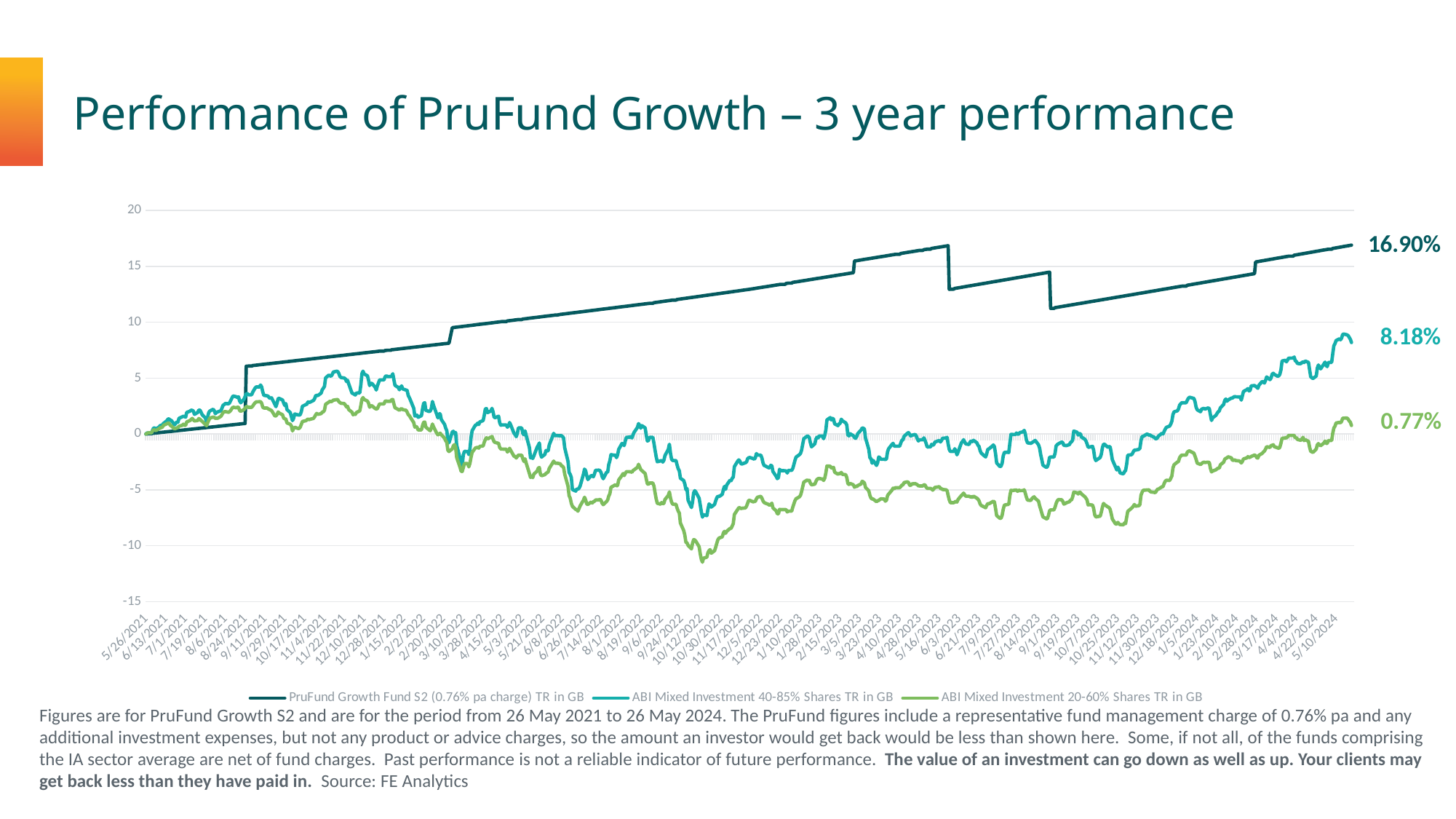
Which series has the highest value at the end of the period? PruFund Growth Fund S2 (0.76% pa charge) TR in GB What is the final value shown for the ABI Mixed Investment 40-85% Shares TR in GB line? 8.18% Which has the larger final value, the ABI Mixed Investment 40-85% Shares line or the ABI Mixed Investment 20-60% Shares line? ABI Mixed Investment 40-85% Shares TR in GB What kind of chart is shown on the slide? Line chart Does the PruFund Growth Fund S2 line generally rise or fall from 5/26/2021 to 5/10/2024? Rise What is the final value shown for the ABI Mixed Investment 20-60% Shares TR in GB line? 0.77% How many series does the legend list? 3 Is the value of the ABI Mixed Investment 20-60% Shares line around 10/12/2022 greater or less than -10? less What is the final value shown for the PruFund Growth Fund S2 (0.76% pa charge) TR in GB line? 16.90% What is the difference between the final values of the ABI Mixed Investment 40-85% Shares line and the ABI Mixed Investment 20-60% Shares line? 7.41% Which series has the lowest value at the end of the period? ABI Mixed Investment 20-60% Shares TR in GB What is the difference between the final values of the PruFund Growth Fund S2 line and the ABI Mixed Investment 40-85% Shares line? 8.72%